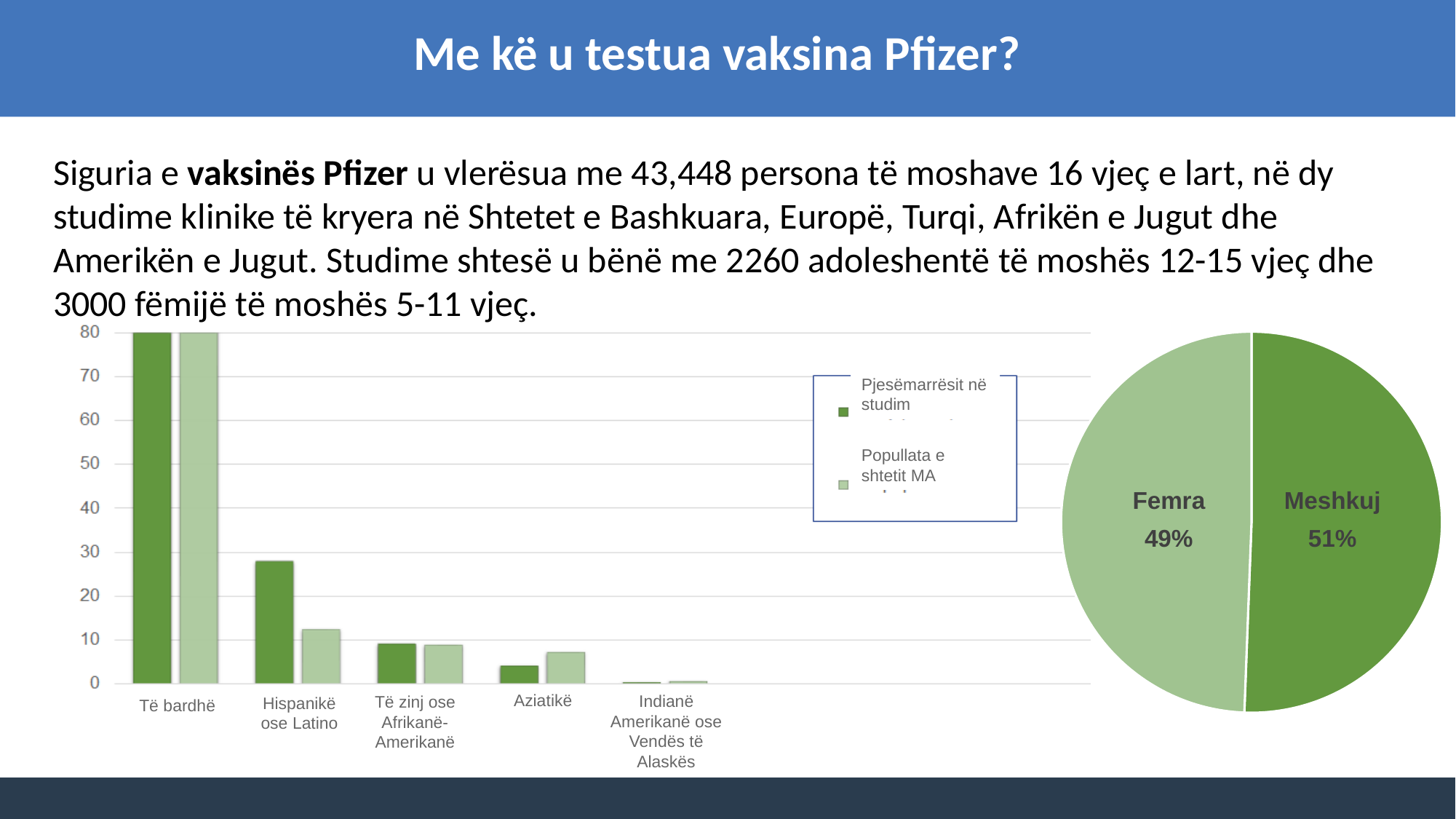
On the bar chart on the left, how many series does the legend list? 2 On the bar chart on the left, how many categories are shown on the x axis? 5 On the bar chart on the left, is the Populata e shtetit MA value for Hispanikë ose Latino greater or less than 20? less On the bar chart on the left, which category has the highest values? Të bardhë What kind of chart is the chart on the left of the slide? Bar chart On the bar chart on the left, for Aziatikë, which series has the larger value? Populata e shtetit MA On the pie chart on the right, what share is labelled for Femra? 49% On the pie chart on the right, which slice is larger, Femra or Meshkuj? Meshkuj On the bar chart on the left, which category has the lowest values? Indianë Amerikanë ose Vendës të Alaskës On the bar chart on the left, is the Pjesëmarrësit në studim value for Hispanikë ose Latino greater or less than 20? greater On the pie chart on the right, what share is labelled for Meshkuj? 51% What kind of chart is the chart on the right of the slide? Pie chart